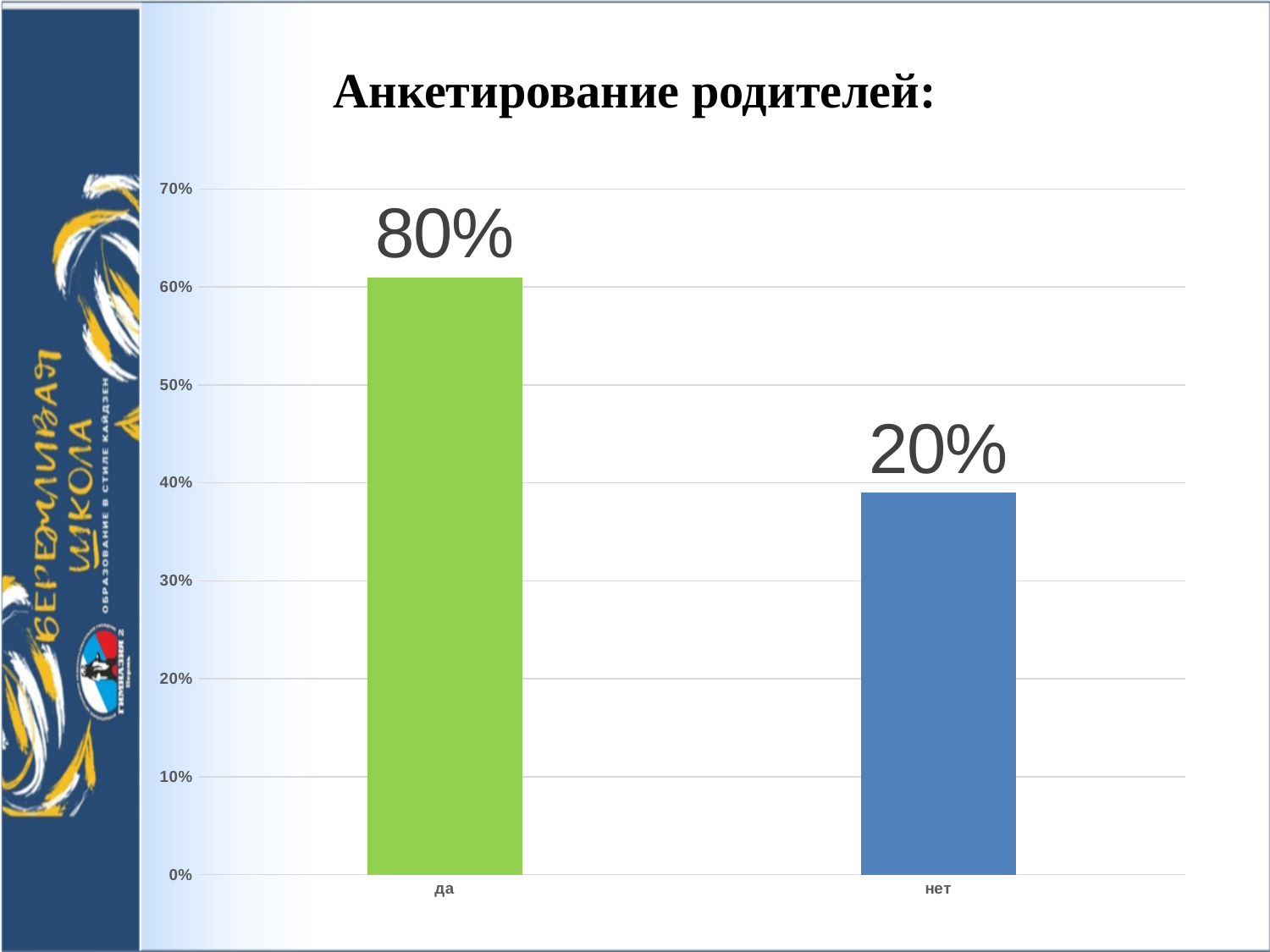
What kind of chart is shown on the slide? bar chart Which is larger, the value for "да" or the value for "нет"? да Which category has the lowest value? нет What is the difference between the values for "да" and "нет"? 60% What value is shown for the category "да"? 80% How many categories are shown on the x axis? 2 What is the title of the slide above the chart? Анкетирование родителей: Is the value for "да" greater or less than 50%? greater What colour is the bar for "да"? green Is the value for "нет" greater or less than 50%? less Which category has the highest value? да What value is shown for the category "нет"? 20%